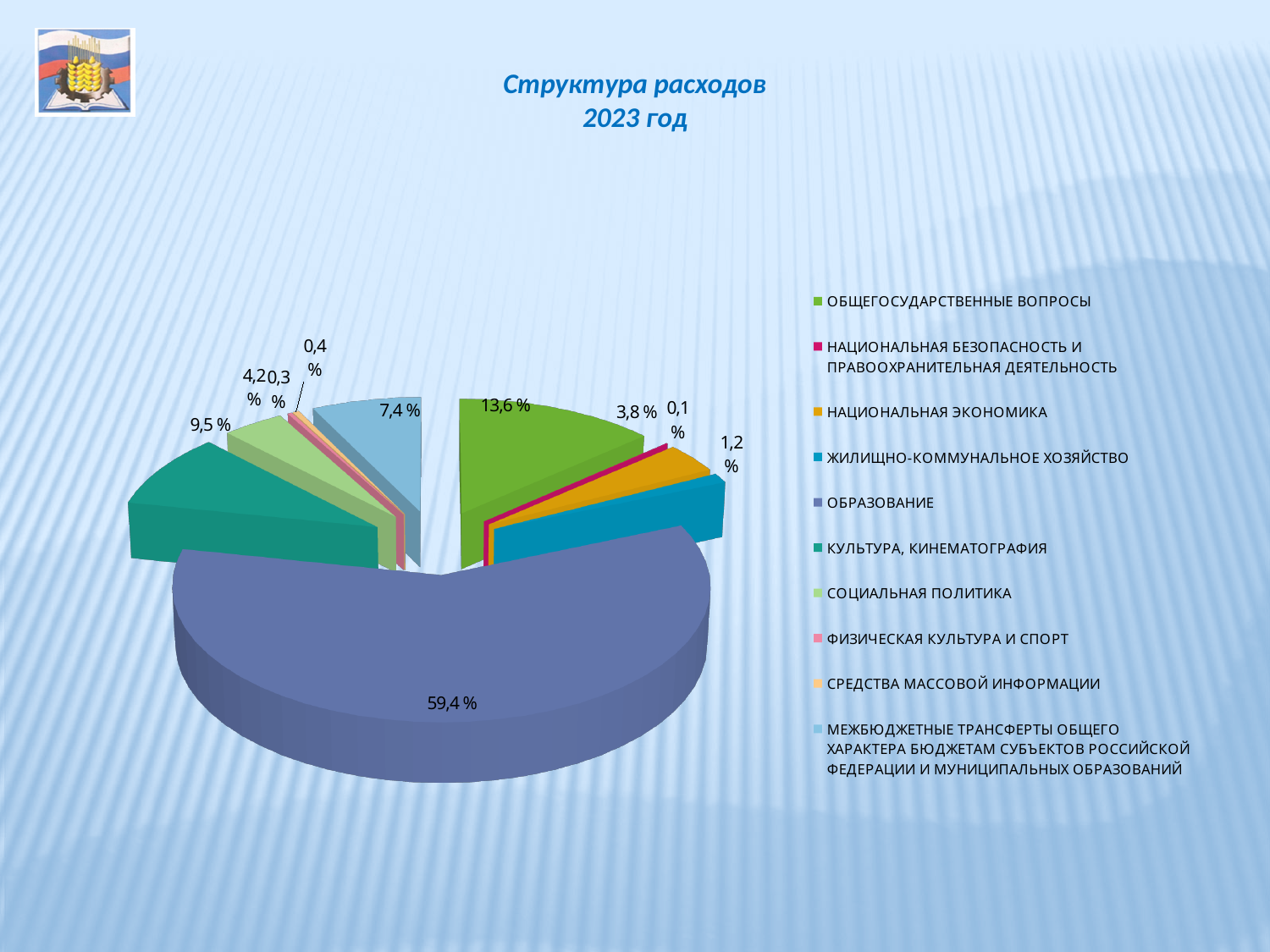
What is the value for МЕЖБЮДЖЕТНЫЕ ТРАНСФЕРТЫ ОБЩЕГО ХАРАКТЕРА БЮДЖЕТАМ СУБЪЕКТОВ РОССИЙСКОЙ ФЕДЕРАЦИИ И МУНИЦИПАЛЬНЫХ ОБРАЗОВАНИЙ? 7,4 % What is the value for СОЦИАЛЬНАЯ ПОЛИТИКА? 4,2 % Which category has the largest share of the pie? ОБРАЗОВАНИЕ What is the title of the chart? Структура расходов 2023 год How many categories does the legend list? 10 What is the value for ОБЩЕГОСУДАРСТВЕННЫЕ ВОПРОСЫ? 13,6 % Which is larger, the share of КУЛЬТУРА, КИНЕМАТОГРАФИЯ or the share of СОЦИАЛЬНАЯ ПОЛИТИКА? КУЛЬТУРА, КИНЕМАТОГРАФИЯ What is the smallest percentage value labelled on the pie? 0,1 % What is the difference between the shares of ОБРАЗОВАНИЕ and ОБЩЕГОСУДАРСТВЕННЫЕ ВОПРОСЫ? 45,8 % What share of the pie does ОБРАЗОВАНИЕ take? 59,4 % What is the value for КУЛЬТУРА, КИНЕМАТОГРАФИЯ? 9,5 % What kind of chart is shown on the slide? pie chart